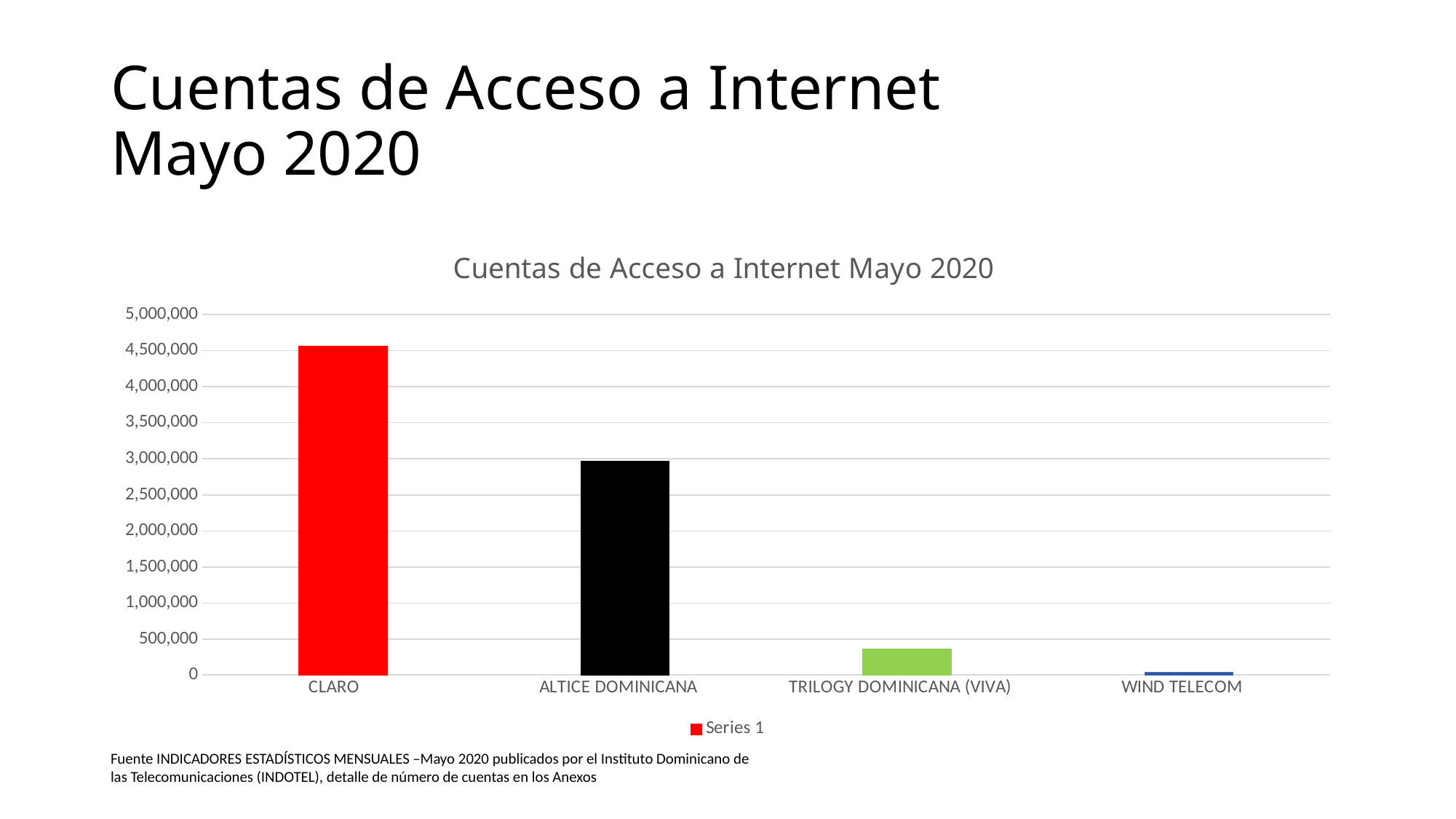
Which category has the lowest value? WIND TELECOM Is the value for TRILOGY DOMINICANA (VIVA) greater or less than 500,000? less Is the value for CLARO greater or less than 4,000,000? greater What is the title of the chart? Cuentas de Acceso a Internet Mayo 2020 Which is larger, the value for ALTICE DOMINICANA or the value for TRILOGY DOMINICANA (VIVA)? ALTICE DOMINICANA Which category has the highest value? CLARO How many categories are shown on the x axis of the chart? 4 Do the values rise or fall from left to right along the x axis? fall What is the name of the series shown in the legend? Series 1 What kind of chart is shown on the slide? bar chart How many series does the legend list? 1